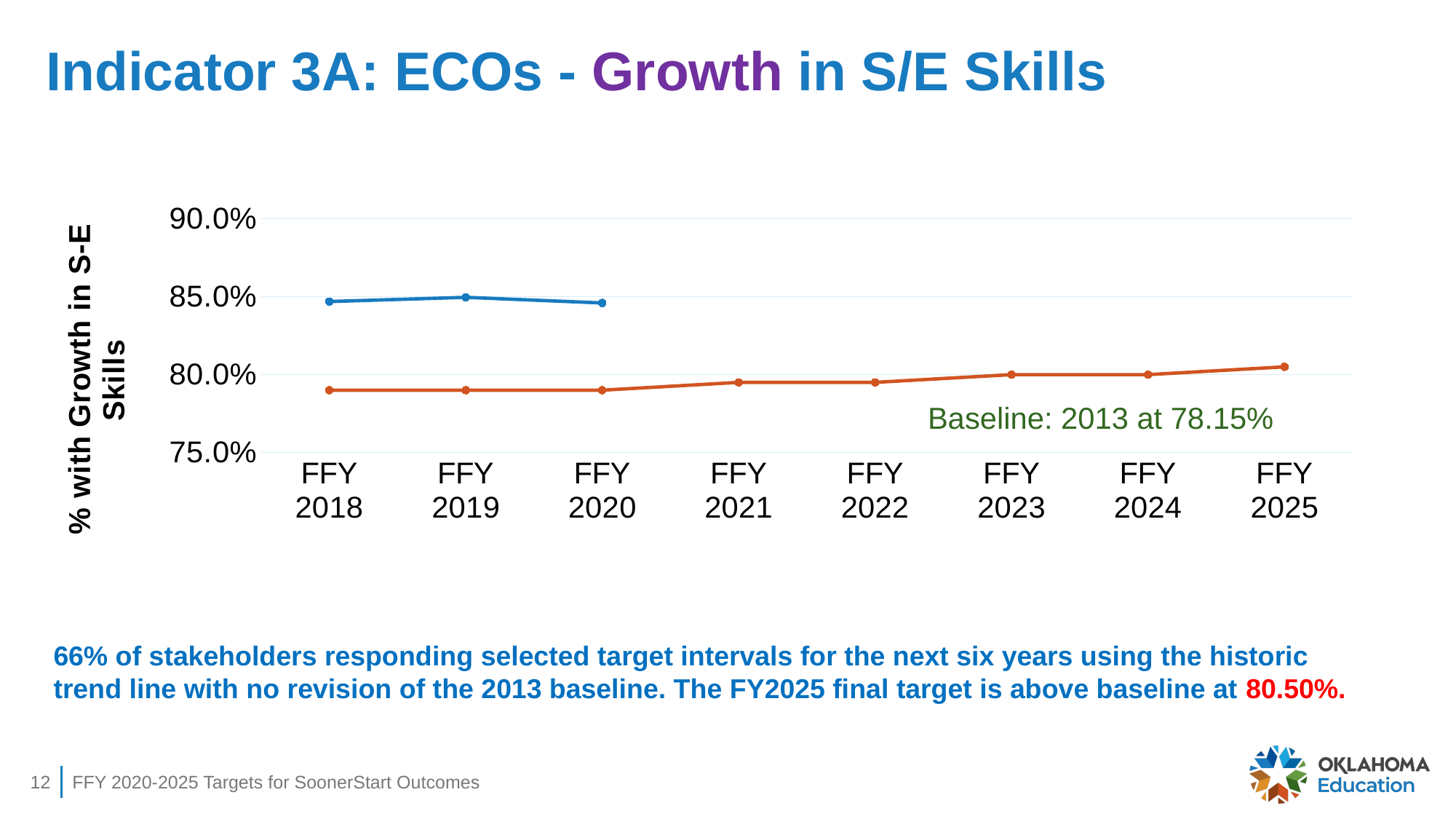
Is the value of the blue line at FFY 2018 greater or less than 90.0%? less Does the orange line rise or fall from FFY 2018 to FFY 2025? rise In which FFY does the blue line reach its highest value? FFY 2019 What kind of chart is shown on the slide? line chart How many FFY categories are shown on the x axis? 8 What baseline value is annotated on the chart? Baseline: 2013 at 78.15% What is the value of the orange line at FFY 2025? 80.50% Is the value of the blue line at FFY 2019 greater or less than 80.0%? greater Is the value of the orange line at FFY 2018 greater or less than 80.0%? less At FFY 2018, which line has the larger value, the blue line or the orange line? the blue line How many data points does the blue line have? 3 What is the title of the y axis? % with Growth in S-E Skills